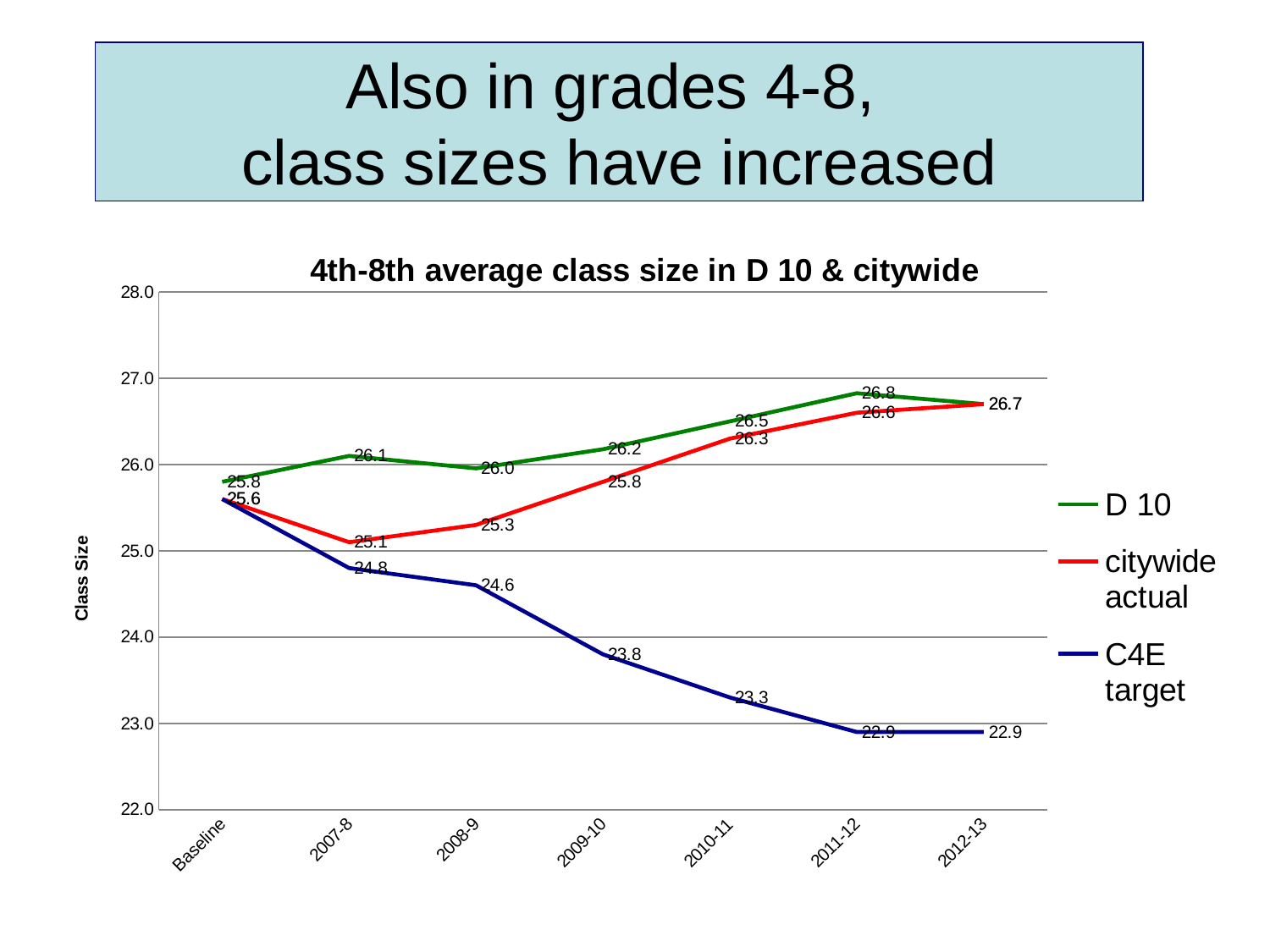
What is the citywide actual average class size in 2010-11? 26.3 In 2008-9, which is larger: the D 10 value or the citywide actual value? D 10 What is the D 10 average class size in 2007-8? 26.1 What is the title of the chart? 4th-8th average class size in D 10 & citywide How many points are plotted along the x axis for each series? 7 In which year does the D 10 series reach its highest value? 2011-12 What is the difference between the D 10 value and the C4E target value in 2011-12? 3.9 Does the C4E target series rise or fall from Baseline to 2012-13? fall What is the C4E target value for 2009-10? 23.8 What kind of chart is shown on the slide? line chart How many series does the legend list? 3 In which year is the citywide actual series at its lowest? 2007-8